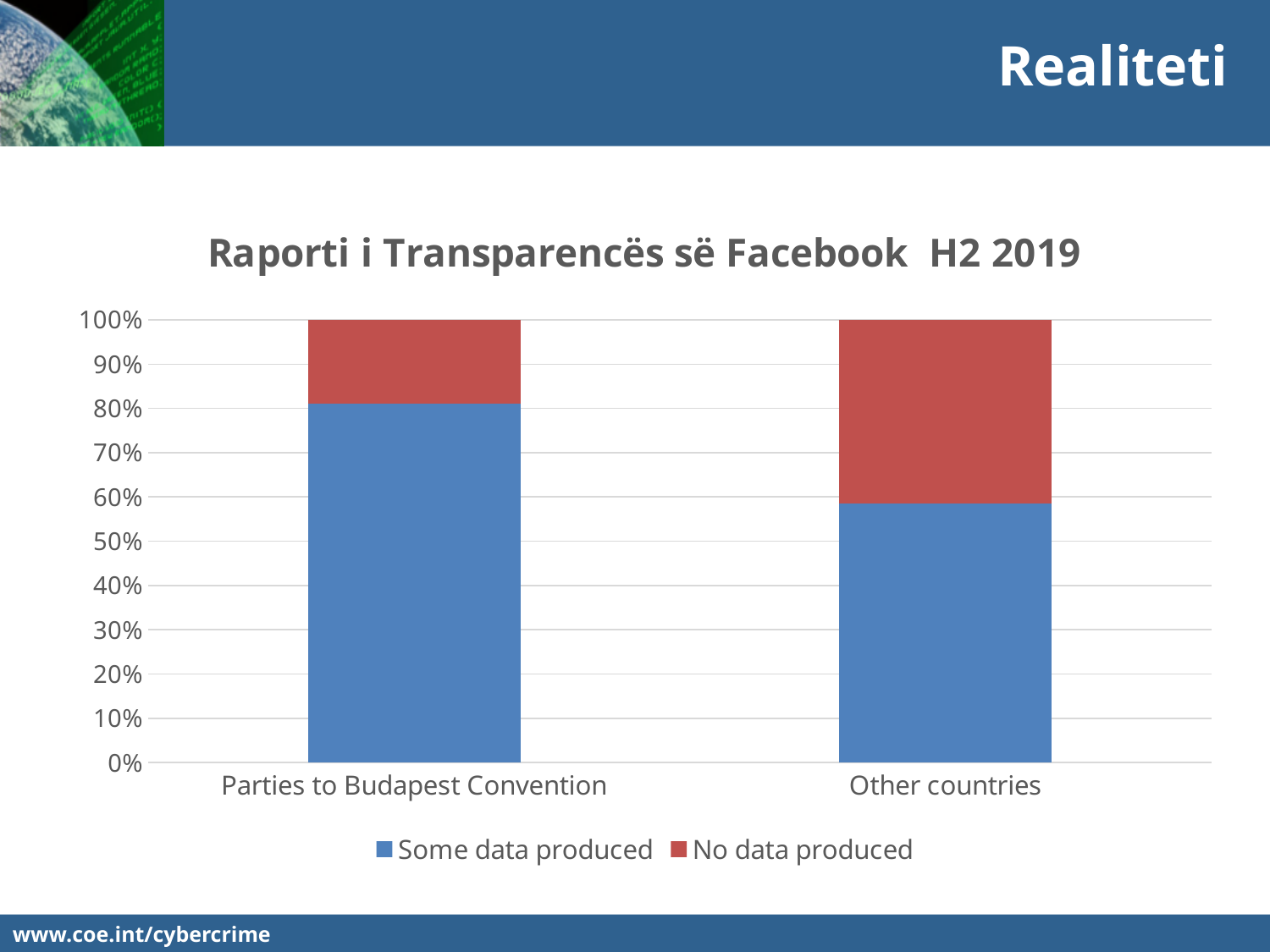
What is the title of the chart? Raporti i Transparencës së Facebook H2 2019 Is the "Some data produced" share for Other countries greater or less than 50%? greater How many categories are shown on the x axis of the chart? 2 How many series does the legend list? 2 Which category has the larger share for "No data produced": Parties to Budapest Convention or Other countries? Other countries What kind of chart is shown on the slide? Stacked bar chart Is the "No data produced" share for Other countries greater or less than 30%? greater Is the "No data produced" share for Parties to Budapest Convention greater or less than 30%? less Which category has the larger share for "Some data produced": Parties to Budapest Convention or Other countries? Parties to Budapest Convention Which series is shown in red in the chart? No data produced What is the total height of the stacked bar for Other countries? 100%